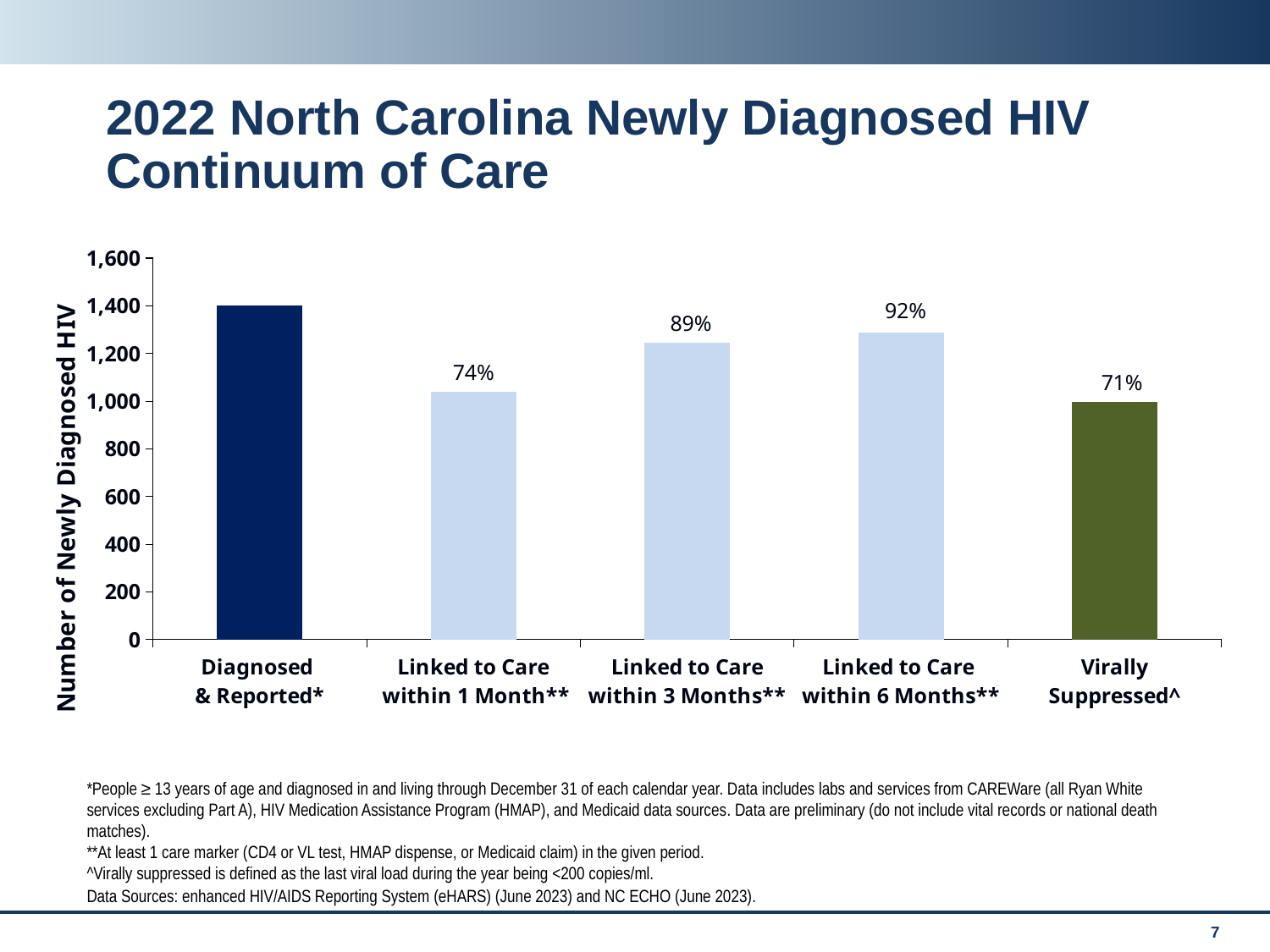
What is the title of the y axis? Number of Newly Diagnosed HIV What percentage label is shown on the 'Linked to Care within 1 Month**' bar? 74% What percentage label is shown on the 'Virally Suppressed^' bar? 71% How many categories are shown on the x axis of the chart? 5 What percentage label is shown on the 'Linked to Care within 6 Months**' bar? 92% Is the value for 'Diagnosed & Reported*' greater or less than 1,200? greater What percentage label is shown on the 'Linked to Care within 3 Months**' bar? 89% What kind of chart is shown on the slide? Bar chart Which category has the tallest bar in the chart? Diagnosed & Reported* Which labelled bar shows the lowest percentage? Virally Suppressed^ Which bar is taller: 'Linked to Care within 3 Months**' or 'Linked to Care within 1 Month**'? Linked to Care within 3 Months** What is the difference in percentage points between the 'Linked to Care within 6 Months**' label and the 'Linked to Care within 1 Month**' label? 18 percentage points